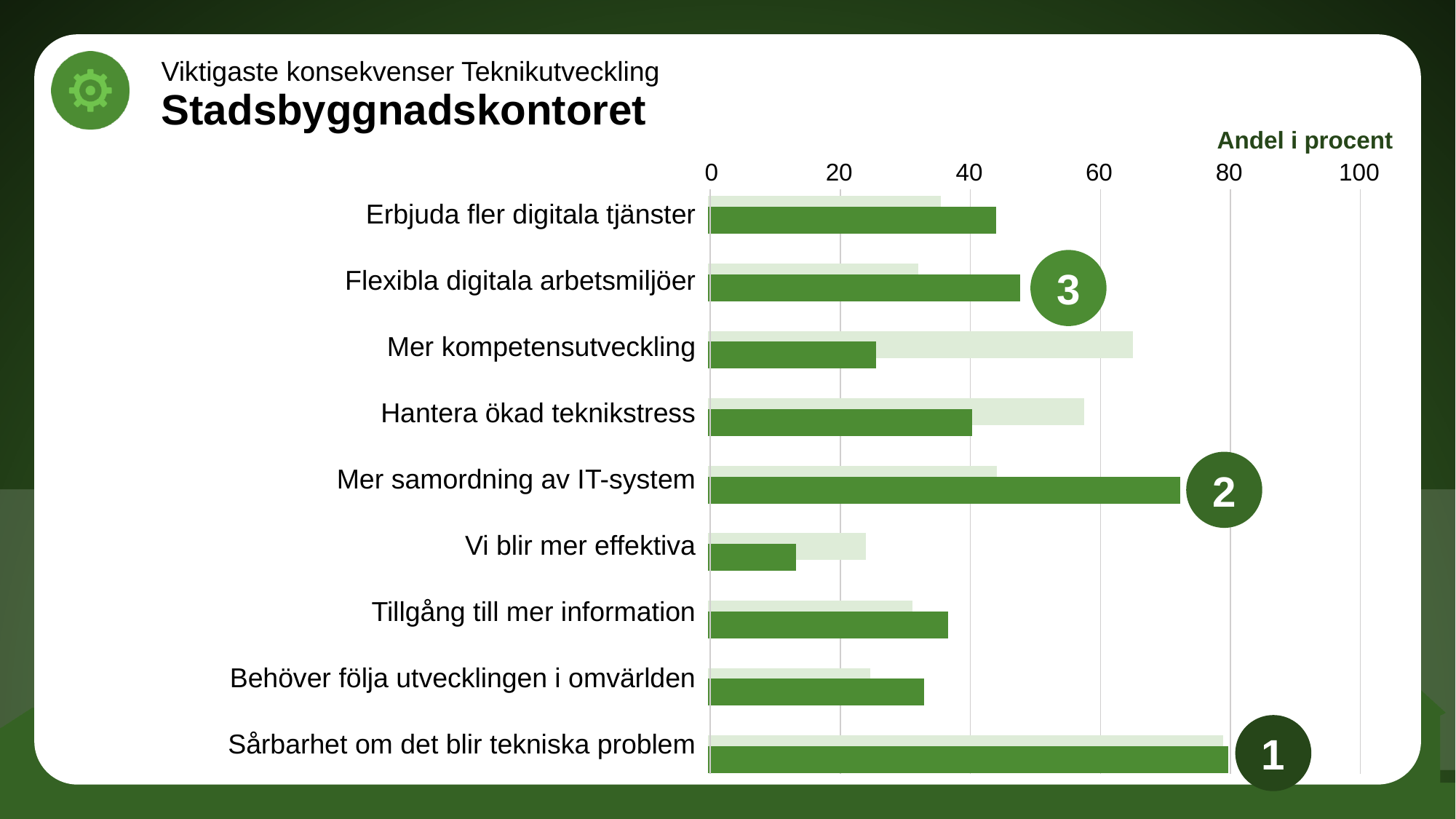
Is the dark green value for Flexibla digitala arbetsmiljöer greater or less than 40? greater How many categories are listed on the chart? 9 Is the light green value for Mer kompetensutveckling greater or less than 60? greater What is the label shown above the horizontal axis of the chart? Andel i procent Which category has the shortest dark green bar? Vi blir mer effektiva For Mer kompetensutveckling, which bar is longer: the light green or the dark green? light green Which category has the longest light green bar? Sårbarhet om det blir tekniska problem Is the dark green value for Mer samordning av IT-system greater or less than 60? greater Which has the larger dark green value: Mer samordning av IT-system or Hantera ökad teknikstress? Mer samordning av IT-system Which category has the longest dark green bar? Sårbarhet om det blir tekniska problem What kind of chart is shown on the slide? bar chart